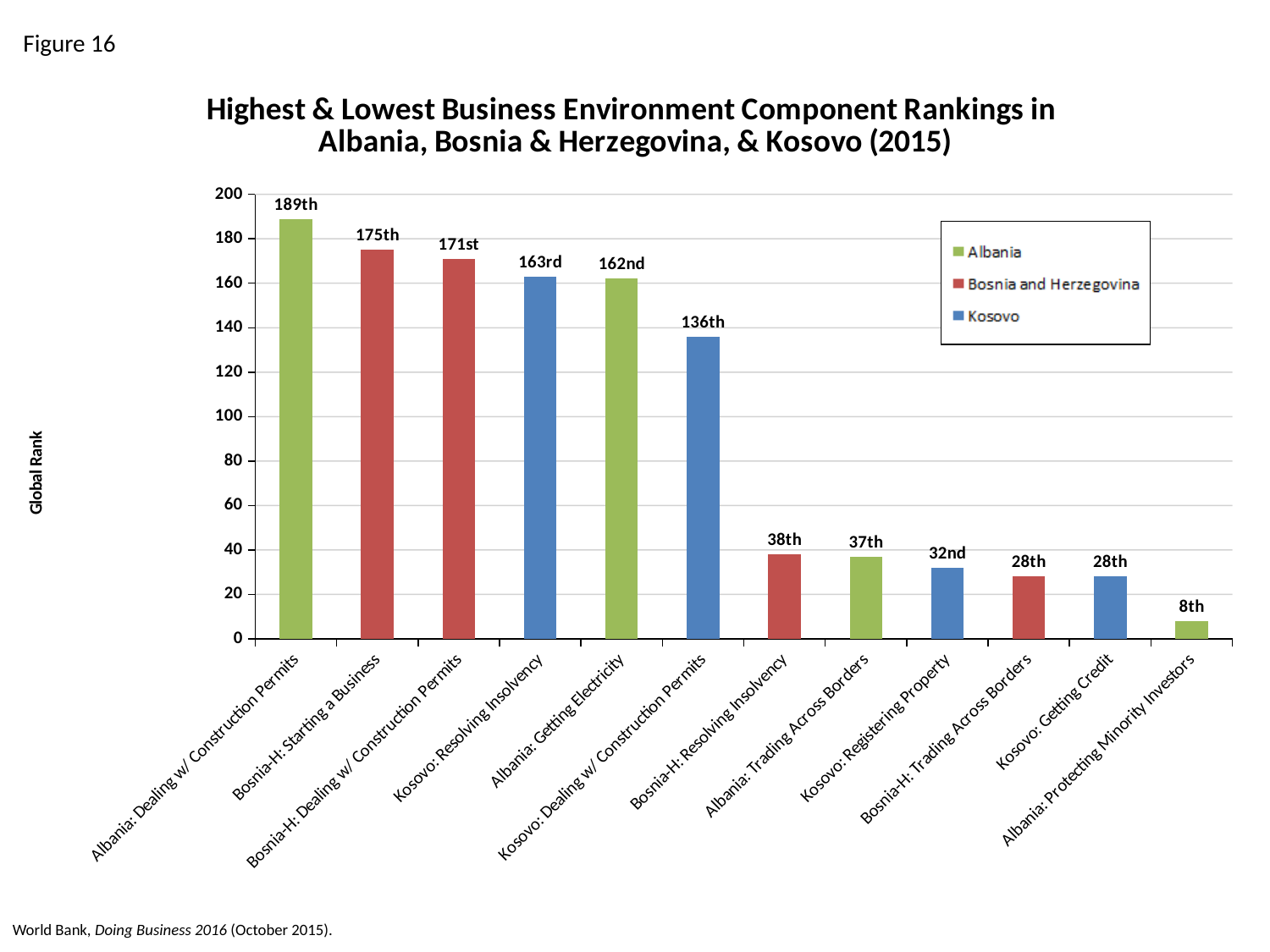
Which bar is taller: Kosovo: Dealing w/ Construction Permits or Albania: Getting Electricity? Albania: Getting Electricity Which category has the lowest bar in the chart? Albania: Protecting Minority Investors What is the global rank shown for Bosnia-H: Resolving Insolvency? 38th How many categories are plotted on the x axis? 12 What is the label of the vertical axis? Global Rank What is the global rank shown for Albania: Protecting Minority Investors? 8th What is the difference in rank between Bosnia-H: Starting a Business and Bosnia-H: Dealing w/ Construction Permits? 4 How many series does the legend list? 3 What kind of chart is shown on the slide? Bar chart What is the global rank shown for Albania: Dealing w/ Construction Permits? 189th What is the global rank shown for Kosovo: Resolving Insolvency? 163rd Which category has the highest bar in the chart? Albania: Dealing w/ Construction Permits